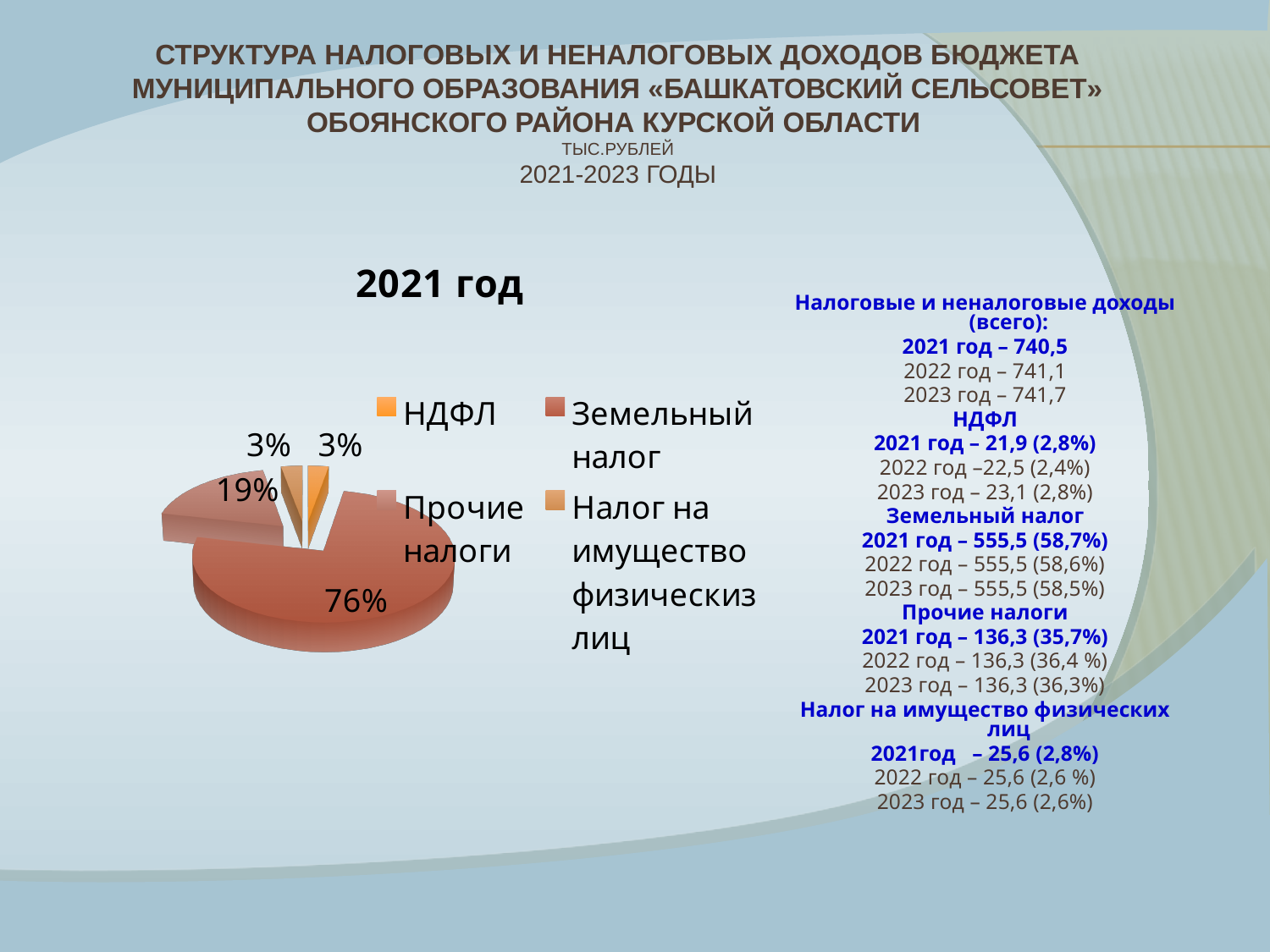
What kind of chart is shown on the slide? pie chart How many entries does the legend of the pie chart list? 4 What colour is the Земельный налог slice in the pie chart? red By how many percentage points does the Земельный налог slice exceed the Прочие налоги slice? 57 What share of the pie does НДФЛ have? 3% What share of the pie does Прочие налоги have? 19% How many slices does the pie chart have? 4 What is the title of the pie chart? 2021 год Which is larger in the pie chart, Земельный налог or Прочие налоги? Земельный налог What share of the pie does Земельный налог have? 76% What is the smallest percentage label shown on the pie chart? 3% Which category has the largest slice in the pie chart? Земельный налог